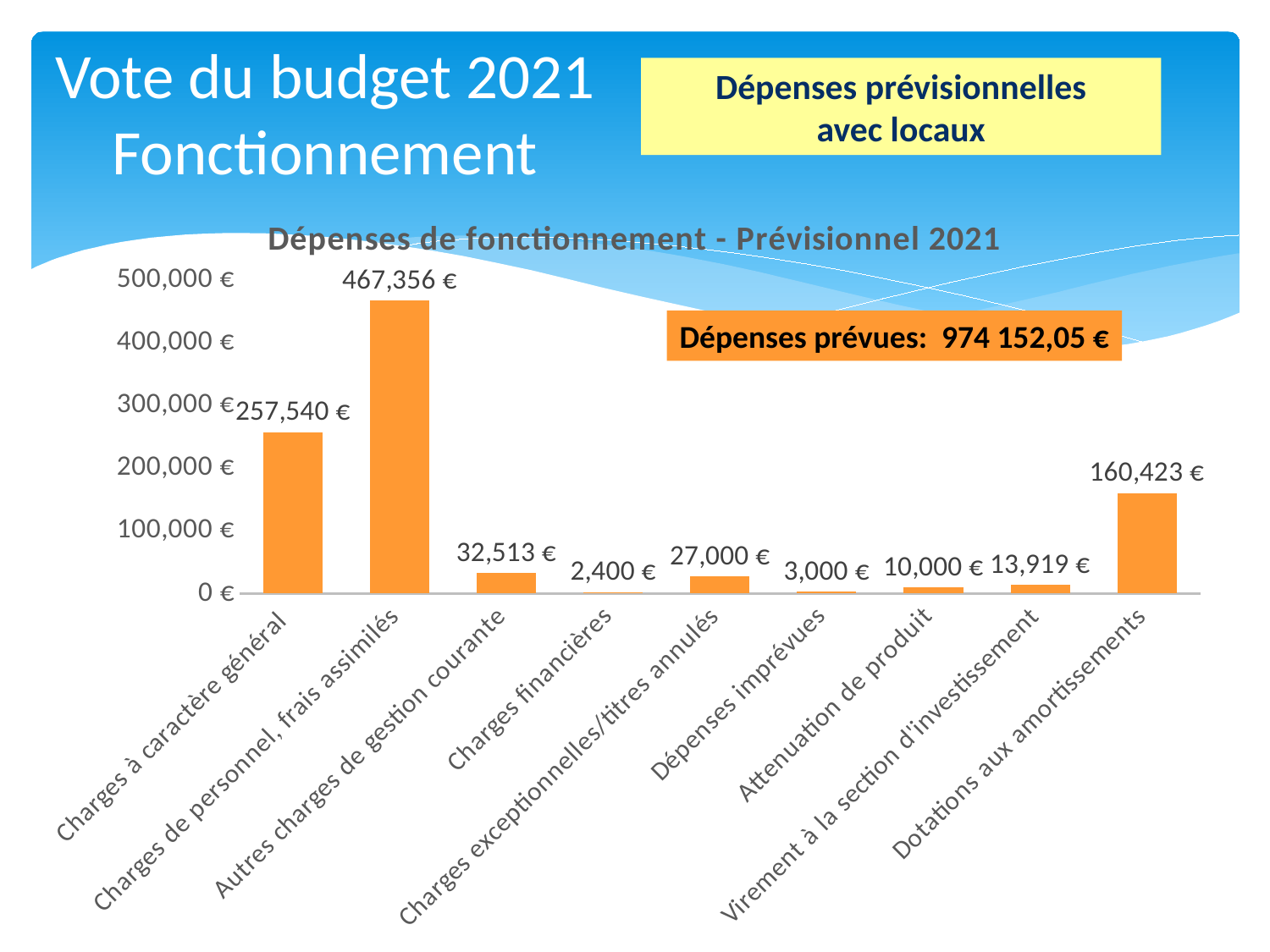
What is the value for Virement à la section d'investissement? 13,919 € Is the value for Charges à caractère général greater or less than 200,000 €? greater What is the value for Charges financières? 2,400 € What is the difference between Charges de personnel, frais assimilés and Charges à caractère général? 209,816 € What is the value for Dotations aux amortissements? 160,423 € What is the difference between Dotations aux amortissements and Autres charges de gestion courante? 127,910 € How many categories are shown in the chart? 9 Which category has the highest value? Charges de personnel, frais assimilés Which category has the lowest value? Charges financières What type of chart is shown on the slide? Bar chart What is the value for Charges de personnel, frais assimilés? 467,356 € Which is larger, Autres charges de gestion courante or Charges exceptionnelles/titres annulés? Autres charges de gestion courante